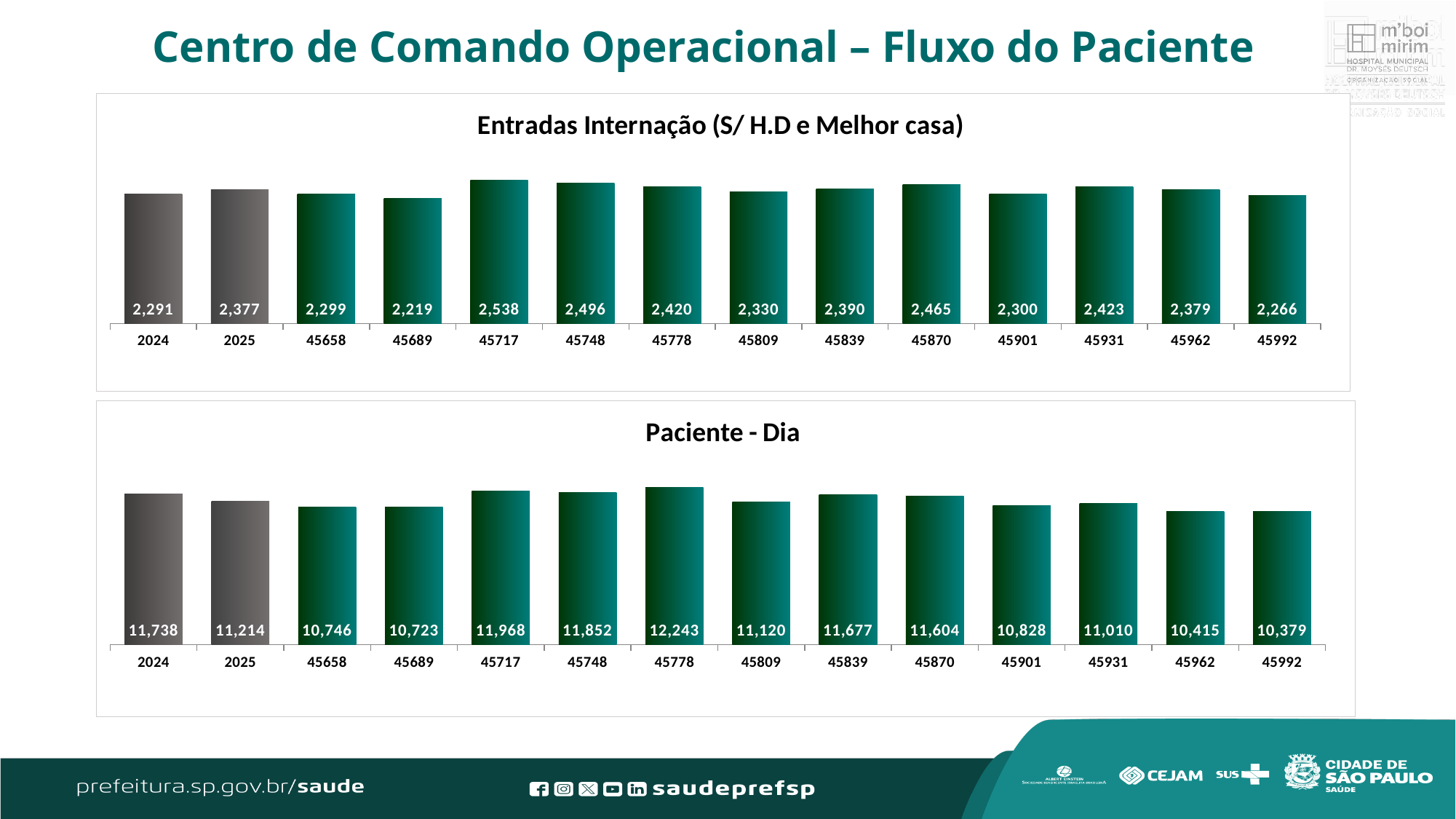
In the 'Entradas Internação (S/ H.D e Melhor casa)' chart, what is the value for 2025? 2,377 In the 'Entradas Internação (S/ H.D e Melhor casa)' chart, which category has the lowest value? 45689 In the 'Paciente - Dia' chart, which category has the highest value? 45778 In the 'Paciente - Dia' chart, what is the difference between the values for 2024 and 2025? 524 In the 'Paciente - Dia' chart, which category has the lowest value? 45992 What kind of chart is the 'Paciente - Dia' chart? Bar chart What is the title of the top chart on the slide? Entradas Internação (S/ H.D e Melhor casa) In the 'Entradas Internação (S/ H.D e Melhor casa)' chart, how many bars are plotted? 14 In the 'Paciente - Dia' chart, which is larger, the value for 2024 or the value for 2025? 2024 In the 'Paciente - Dia' chart, what is the value for 45778? 12,243 In the 'Entradas Internação (S/ H.D e Melhor casa)' chart, what is the difference between the values for 45717 and 45689? 319 In the 'Entradas Internação (S/ H.D e Melhor casa)' chart, which category has the highest value? 45717